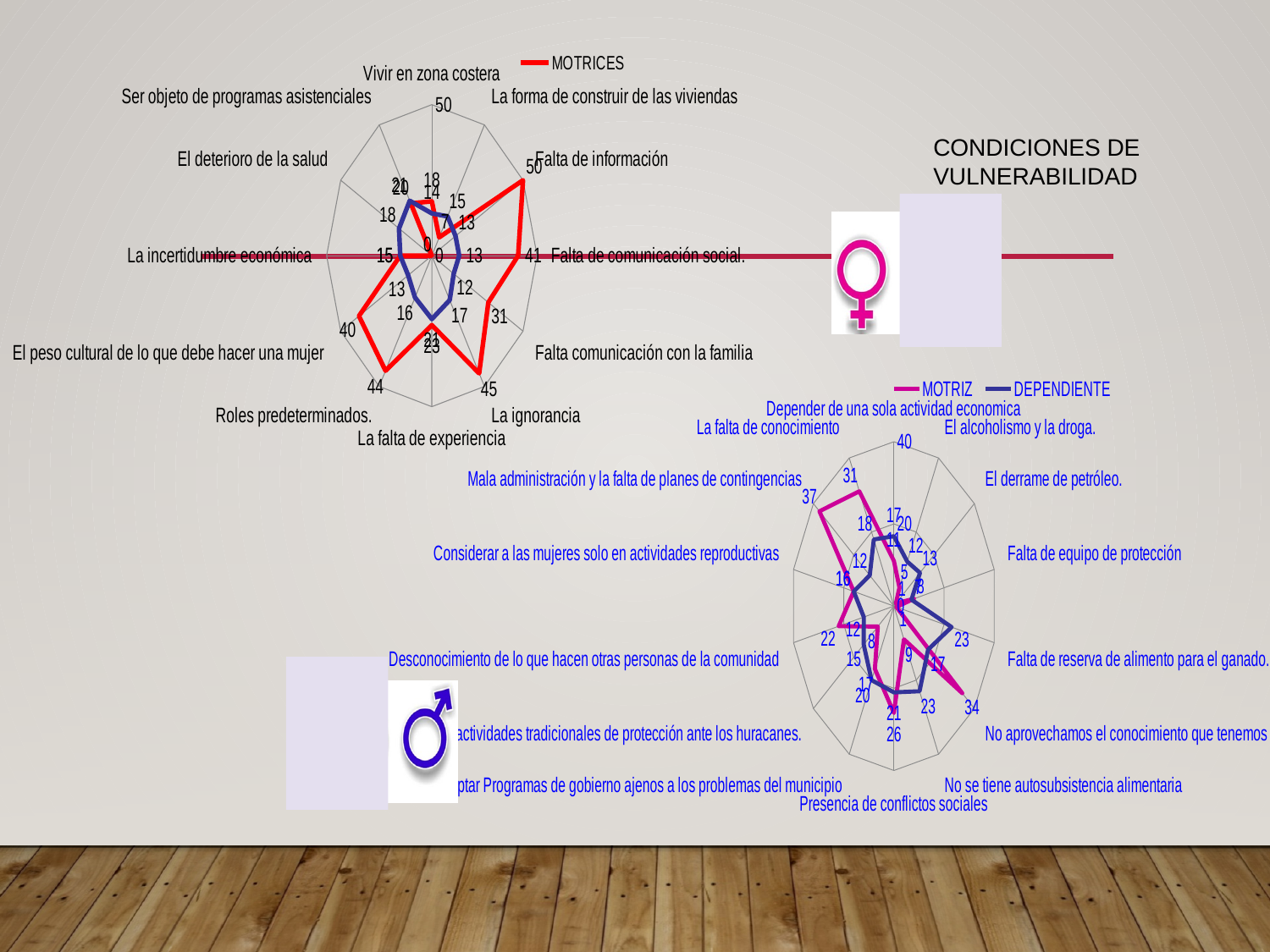
In the left chart (legend 'MOTRICES'), what is the MOTRICES value for 'Roles predeterminados'? 44 In the right chart (legend 'MOTRIZ' / 'DEPENDIENTE'), which is larger for MOTRIZ: 'Mala administración y la falta de planes de contingencias' or 'La falta de conocimiento'? Mala administración y la falta de planes de contingencias In the right chart (legend 'MOTRIZ' / 'DEPENDIENTE'), what is the MOTRIZ value for 'No aprovechamos el conocimiento que tenemos'? 34 In the left chart (legend 'MOTRICES'), what is the difference between the MOTRICES values for 'La ignorancia' and 'Roles predeterminados'? 1 In the left chart (legend 'MOTRICES'), what is the MOTRICES value for 'Falta de información'? 50 In the left chart (legend 'MOTRICES'), which category has the highest MOTRICES value? Falta de información In the right chart (legend 'MOTRIZ' / 'DEPENDIENTE'), what is the MOTRIZ value for 'Mala administración y la falta de planes de contingencias'? 37 In the left chart (legend 'MOTRICES'), what is the MOTRICES value for 'La ignorancia'? 45 In the left chart (legend 'MOTRICES'), which is larger for MOTRICES: 'El peso cultural de lo que debe hacer una mujer' or 'Falta comunicación con la familia'? El peso cultural de lo que debe hacer una mujer How many series does the legend of the right chart (legend 'MOTRIZ' / 'DEPENDIENTE') list? 2 In the left chart (legend 'MOTRICES'), what is the MOTRICES value for 'Falta de comunicación social'? 41 What kind of chart is the chart on the left of the slide (legend 'MOTRICES')? Radar chart